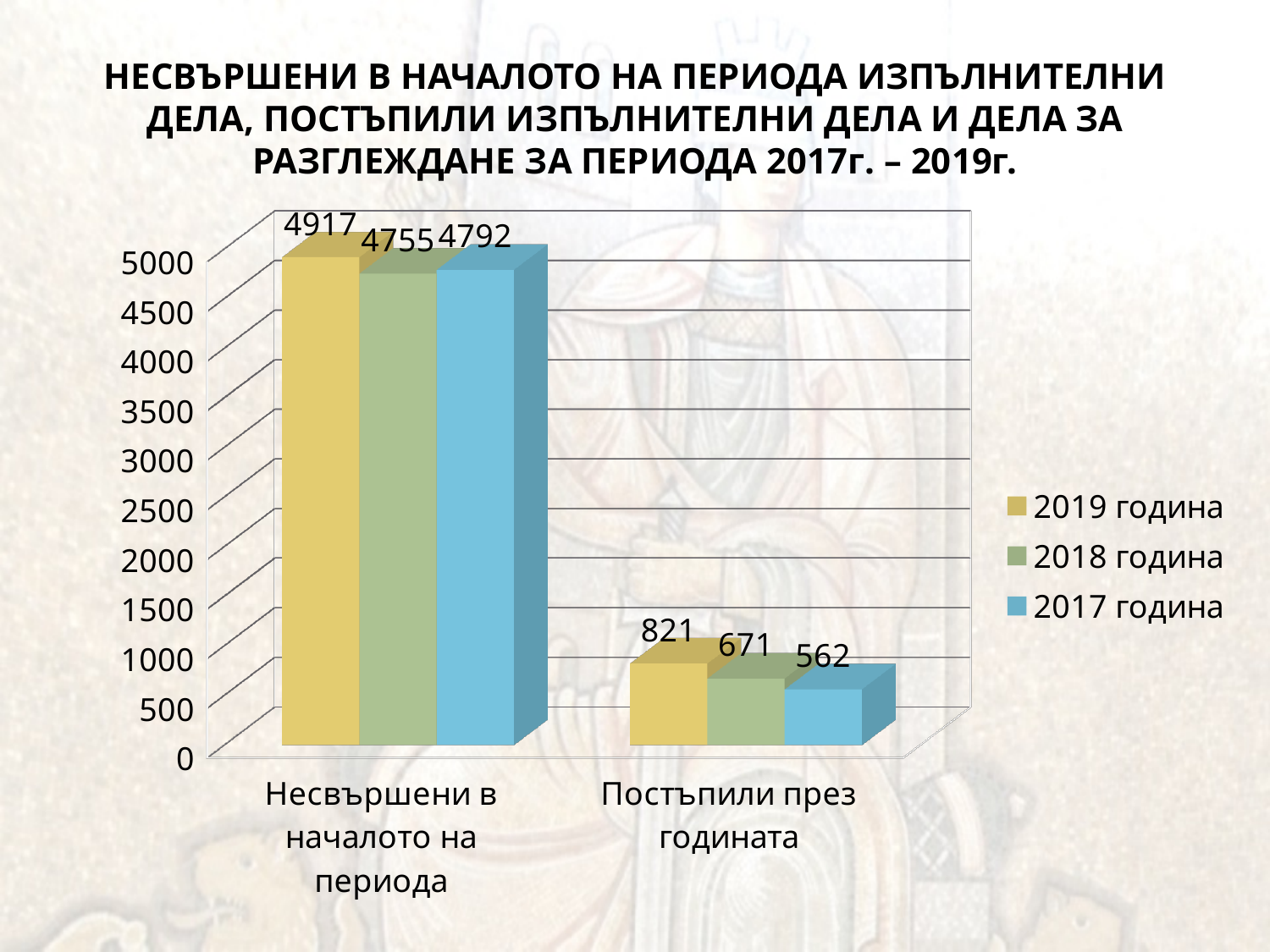
What is the value for 2018 година in the category Постъпили през годината? 671 Which year has the lowest value in the category Несвършени в началото на периода? 2018 година What is the difference between the 2019 година and 2017 година values in the category Постъпили през годината? 259 Which is larger: the 2017 година value or the 2018 година value in the category Несвършени в началото на периода? 2017 година What is the value for 2017 година in the category Постъпили през годината? 562 What is the value for 2018 година in the category Несвършени в началото на периода? 4755 How many categories are shown on the x axis? 2 What is the difference between the 2019 година and 2018 година values in the category Несвършени в началото на периода? 162 Which year has the highest value in the category Постъпили през годината? 2019 година What kind of chart is shown on the slide? Bar chart What is the value for 2019 година in the category Несвършени в началото на периода? 4917 How many series does the legend list? 3